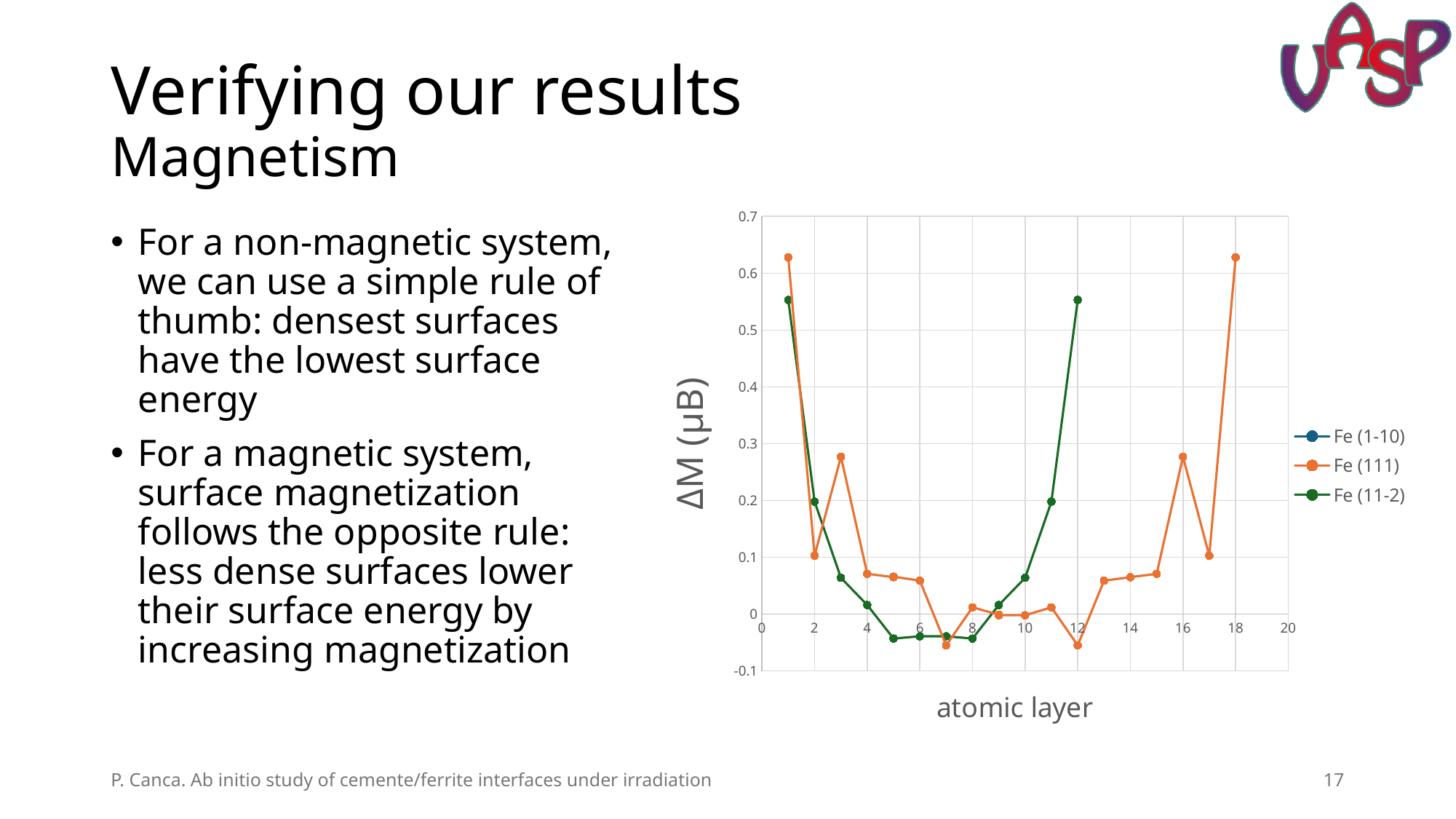
How many data points are plotted for the Fe (11-2) series? 12 How many series does the legend list? 3 At atomic layer 11, which series has the larger value, Fe (111) or Fe (11-2)? Fe (11-2) What kind of chart is shown on the slide? line chart What is the label of the y axis? ΔM (μB) What is the label of the x axis? atomic layer At atomic layer 3, which series has the larger value, Fe (111) or Fe (11-2)? Fe (111) Does the Fe (11-2) series rise or fall from atomic layer 8 to atomic layer 12? rise Is the value for Fe (11-2) at atomic layer 1 greater or less than 0.6? less Is the value for Fe (111) at atomic layer 12 greater or less than 0? less Is the value for Fe (111) at atomic layer 1 greater or less than 0.6? greater